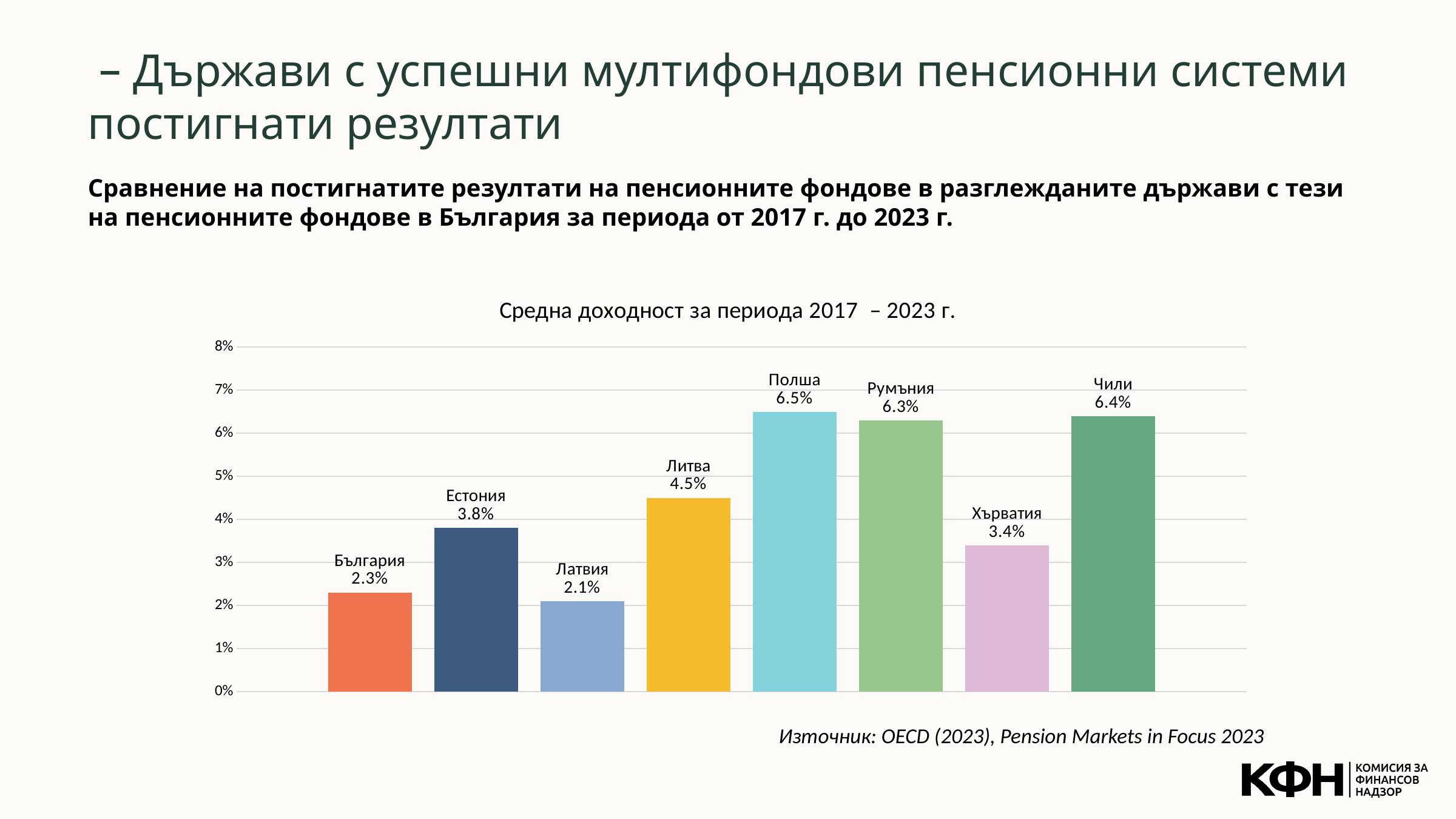
Which country has the highest average return in the chart? Полша What is the average return shown for Литва (Lithuania)? 4.5% Which country has the lowest average return in the chart? Латвия What is the difference between the average return of Полша and that of България? 4.2% What kind of chart is shown on the slide? Bar chart What is the difference between the average return of Естония and that of Латвия? 1.7% Is the value for Естония greater or less than 4%? less What is the average return shown for Хърватия (Croatia)? 3.4% How many countries are shown in the chart? 8 What is the average return shown for България (Bulgaria)? 2.3% Which has a higher average return, Чили or Румъния? Чили What is the title of the chart? Средна доходност за периода 2017 – 2023 г.